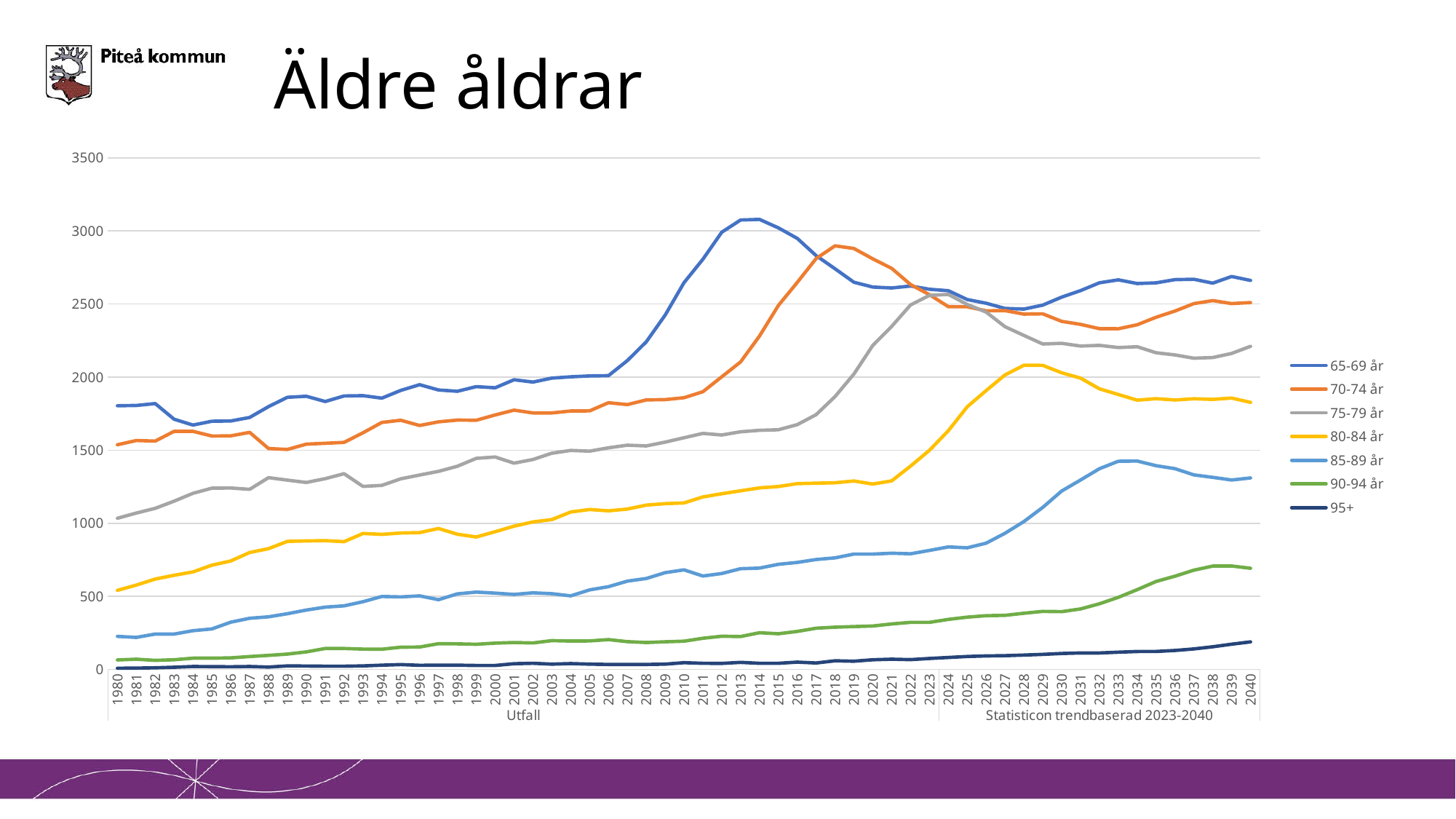
Is the value for 85-89 år in 1980 greater or less than 500? less Is the value for 80-84 år in 2028 greater or less than 1500? greater In 2019, which series is higher: 70-74 år or 75-79 år? 70-74 år What kind of chart is shown on the slide? line chart Is the value for 65-69 år in 2013 greater or less than 2500? greater Which series has the lowest values across the whole chart? 95+ Does the 90-94 år series rise or fall from 1980 to 2040? rise What is the title of the chart? Äldre åldrar Which series reaches the highest value anywhere on the chart? 65-69 år How many series does the legend list? 7 How many years are plotted along the x axis (1980 to 2040)? 61